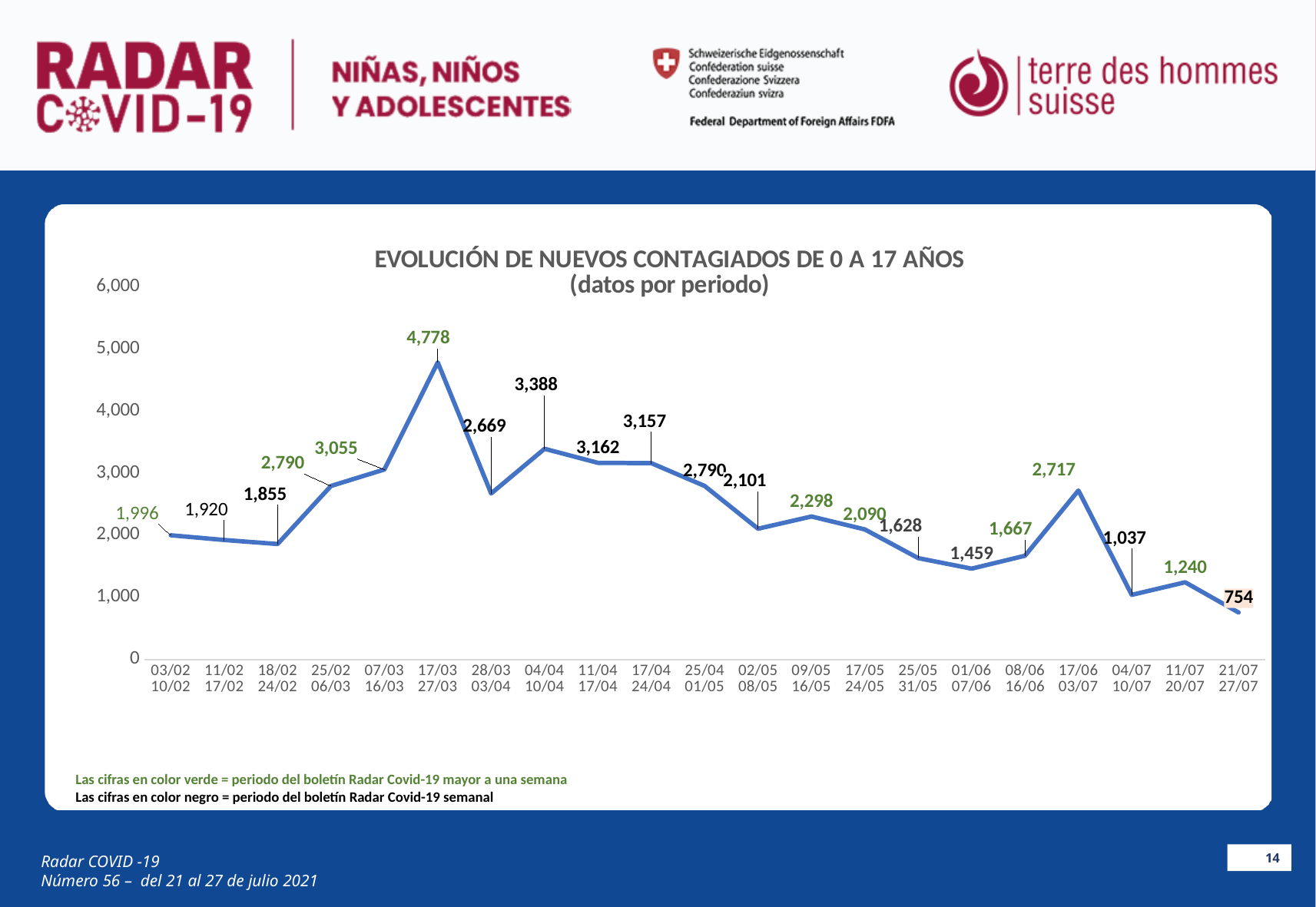
What is the value for the period 17/03–27/03? 4,778 Which is larger, the value for 17/06–03/07 or the value for 09/05–16/05? 17/06–03/07 What is the value for the period 21/07–27/07? 754 Which period has the lowest number of new infections? 21/07–27/07 Which period has the highest number of new infections? 17/03–27/03 According to the note below the chart, what do the figures in green represent? Periodo del boletín Radar Covid-19 mayor a una semana What is the difference between the values for 17/03–27/03 and 04/04–10/04? 1,390 How many periods are plotted on the chart? 21 What is the value for the period 04/04–10/04? 3,388 What is the difference between the values for 11/07–20/07 and 21/07–27/07? 486 What kind of chart is shown on the slide? Line chart Do the values rise or fall from the period 17/06–03/07 to the period 21/07–27/07? Fall